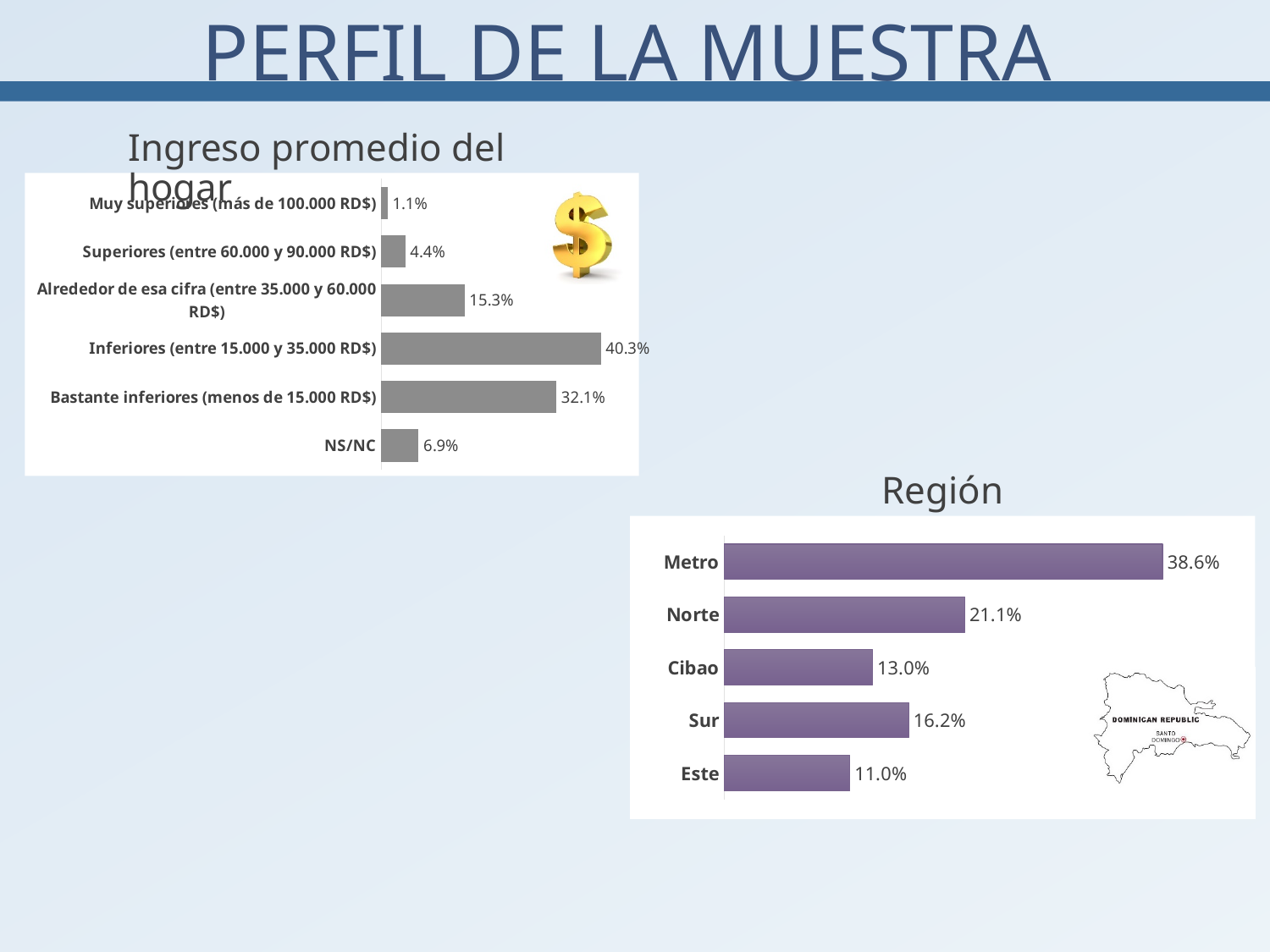
In the 'Ingreso promedio del hogar' chart, what is the value for 'Inferiores (entre 15.000 y 35.000 RD$)'? 40.3% In the 'Ingreso promedio del hogar' chart, what is the difference between 'Inferiores' and 'Bastante inferiores'? 8.2% In the 'Ingreso promedio del hogar' chart, how many categories are shown? 6 In the 'Región' chart, what is the value for Norte? 21.1% In the 'Región' chart, what is the value for Este? 11.0% In the 'Ingreso promedio del hogar' chart, what is the value for NS/NC? 6.9% In the 'Ingreso promedio del hogar' chart, which category has the lowest value? Muy superiores (más de 100.000 RD$) In the 'Ingreso promedio del hogar' chart, which category has the highest value? Inferiores (entre 15.000 y 35.000 RD$) What kind of chart is the 'Región' chart? Bar chart In the 'Región' chart, which region has the highest value? Metro In the 'Región' chart, what is the difference between Metro and Norte? 17.5% In the 'Región' chart, which is larger, Sur or Cibao? Sur